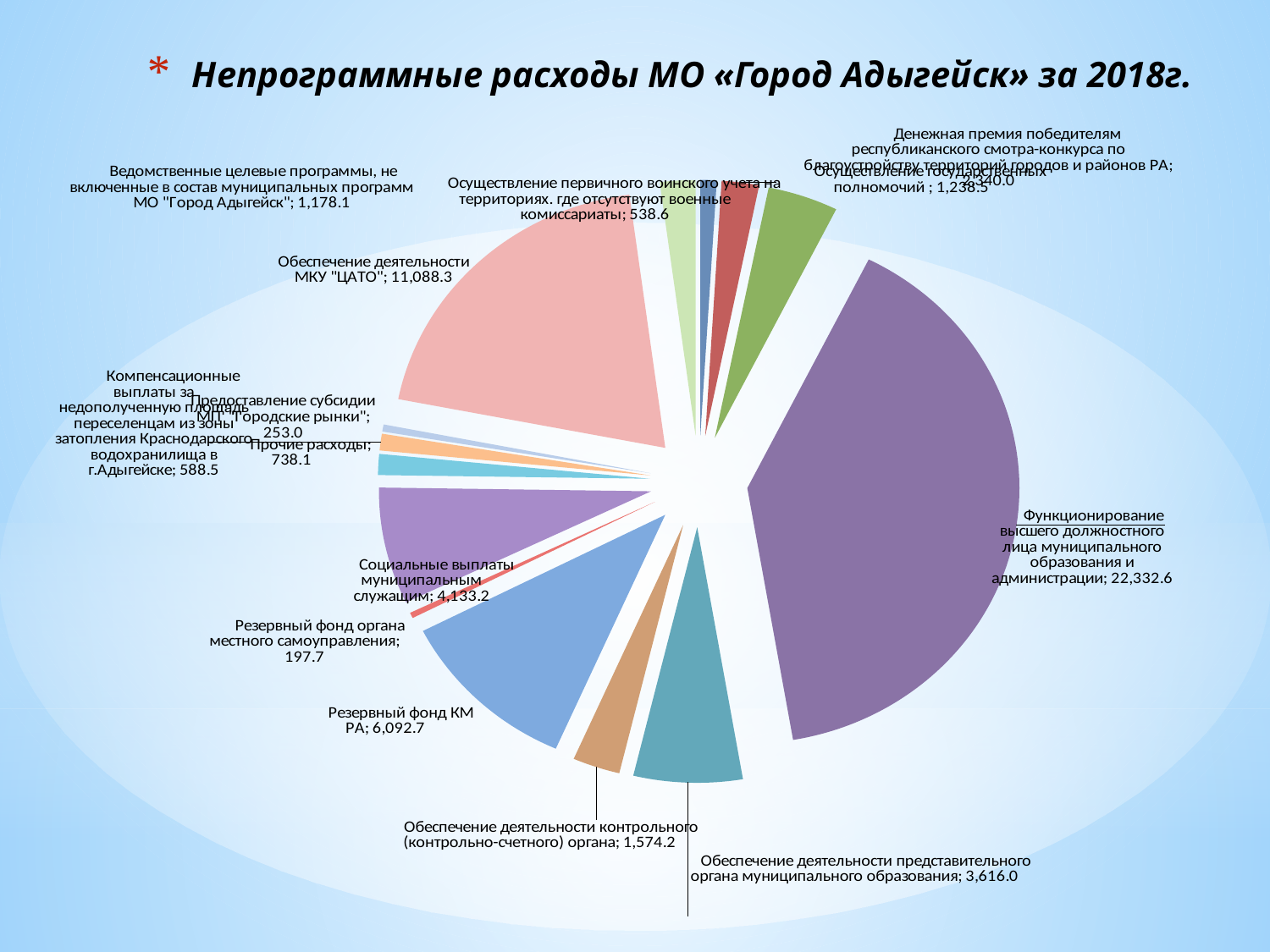
What is the difference between "Социальные выплаты муниципальным служащим" and "Обеспечение деятельности представительного органа муниципального образования"? 517.2 Which category has the smallest value? Резервный фонд органа местного самоуправления What is the title of the chart? Непрограммные расходы МО «Город Адыгейск» за 2018г. What is the value for "Резервный фонд КМ РА"? 6,092.7 What is the difference between "Обеспечение деятельности МКУ "ЦАТО"" and "Резервный фонд КМ РА"? 4,995.6 What is the value for "Обеспечение деятельности МКУ "ЦАТО""? 11,088.3 What is the value for "Социальные выплаты муниципальным служащим"? 4,133.2 Which is larger: "Обеспечение деятельности контрольного (контрольно-счетного) органа" or "Ведомственные целевые программы, не включенные в состав муниципальных программ МО "Город Адыгейск""? Обеспечение деятельности контрольного (контрольно-счетного) органа Which category has the largest value? Функционирование высшего должностного лица муниципального образования и администрации What is the value for "Предоставление субсидии МП "Городские рынки""? 253.0 What type of chart is shown on the slide? pie chart What is the value for "Обеспечение деятельности представительного органа муниципального образования"? 3,616.0